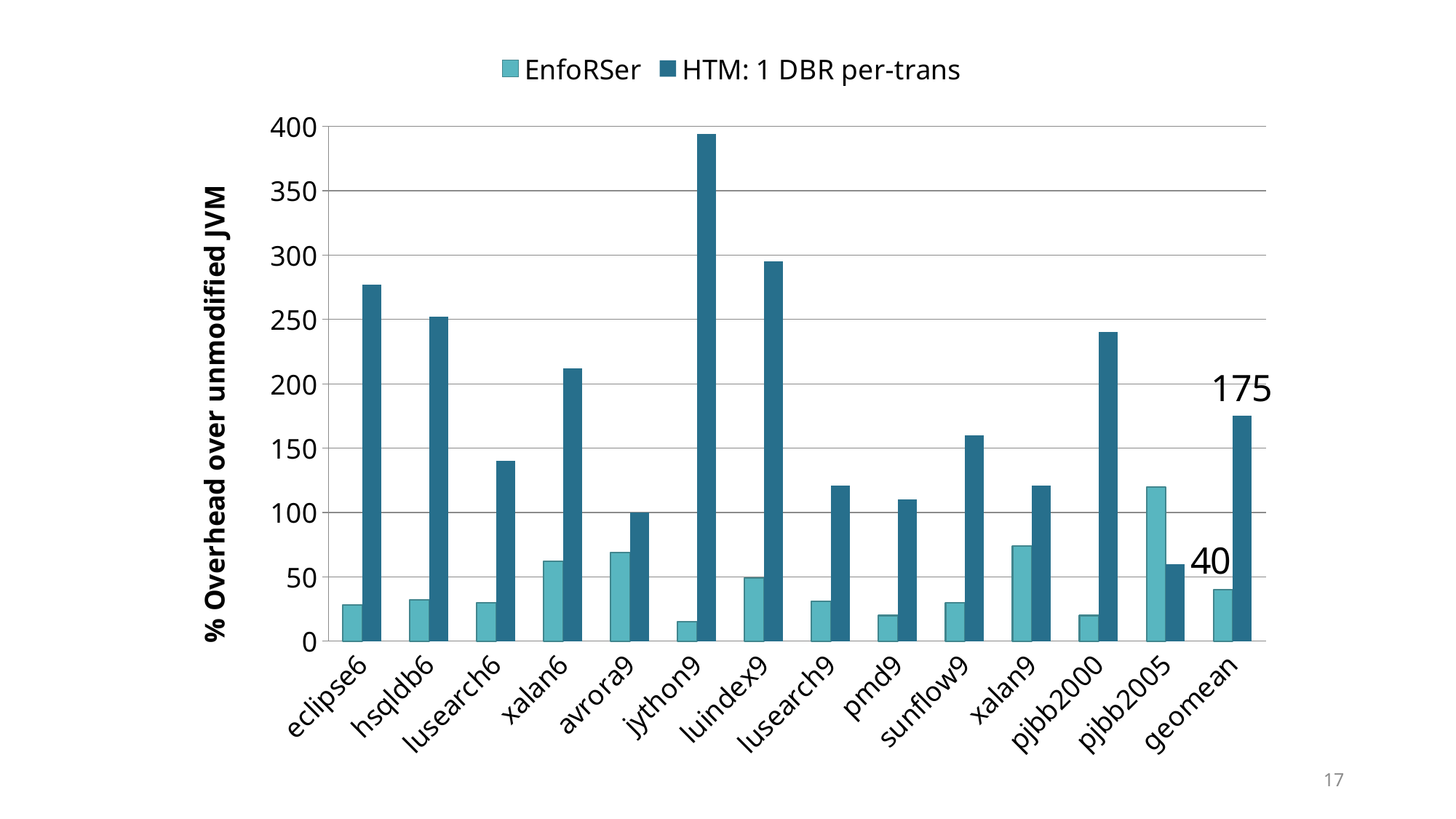
Which benchmark has the highest EnfoRSer overhead? pjbb2005 Is the HTM: 1 DBR per-trans value for avrora9 greater or less than 150? less What is the difference between the HTM: 1 DBR per-trans and EnfoRSer values for geomean? 135 Which benchmark has the lowest EnfoRSer overhead? jython9 What kind of chart is shown on the slide? bar chart How many series does the legend list? 2 What is the value of EnfoRSer for geomean? 40 Is the HTM: 1 DBR per-trans value for eclipse6 greater or less than 250? greater How many benchmark categories are shown on the x axis? 14 Which benchmark has the highest HTM: 1 DBR per-trans overhead? jython9 For pjbb2005, which series has the larger value, EnfoRSer or HTM: 1 DBR per-trans? EnfoRSer What is the value of HTM: 1 DBR per-trans for geomean? 175